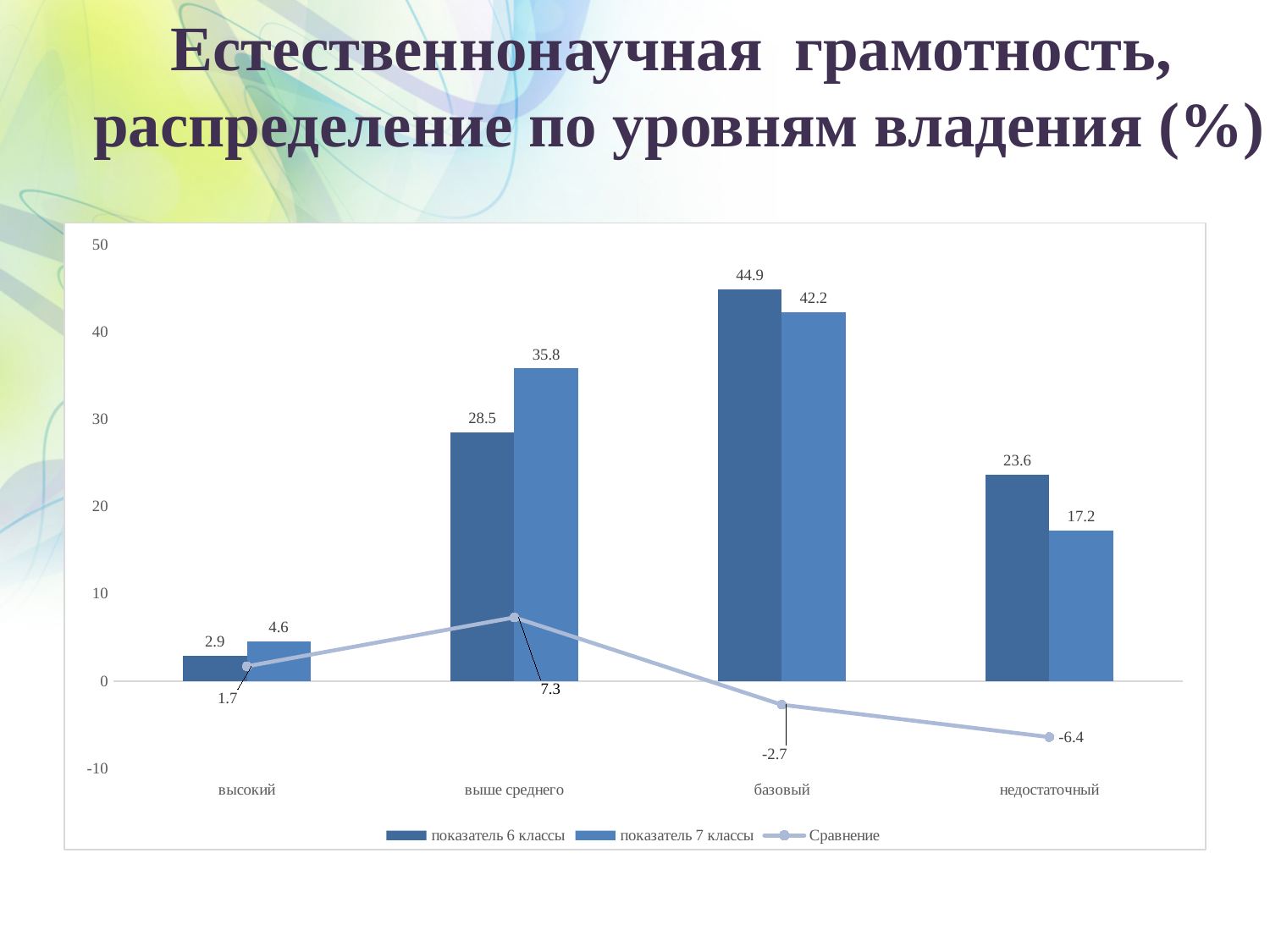
How many categories are shown on the x axis? 4 What is the value of показатель 7 классы for the выше среднего category? 35.8 Which category has the highest value for показатель 7 классы? базовый What is the value of the Сравнение series for the недостаточный category? -6.4 What kind of chart is shown on the slide? Bar chart with a line series Is the value of показатель 6 классы for недостаточный greater or less than 20? greater Which is larger for the выше среднего category: показатель 6 классы or показатель 7 классы? показатель 7 классы Which category has the lowest value for показатель 6 классы? высокий What is the value of показатель 6 классы for the базовый category? 44.9 What is the difference between показатель 6 классы and показатель 7 классы for the недостаточный category? 6.4 How many series does the legend list? 3 What is the title of the slide? Естественнонаучная грамотность, распределение по уровням владения (%)